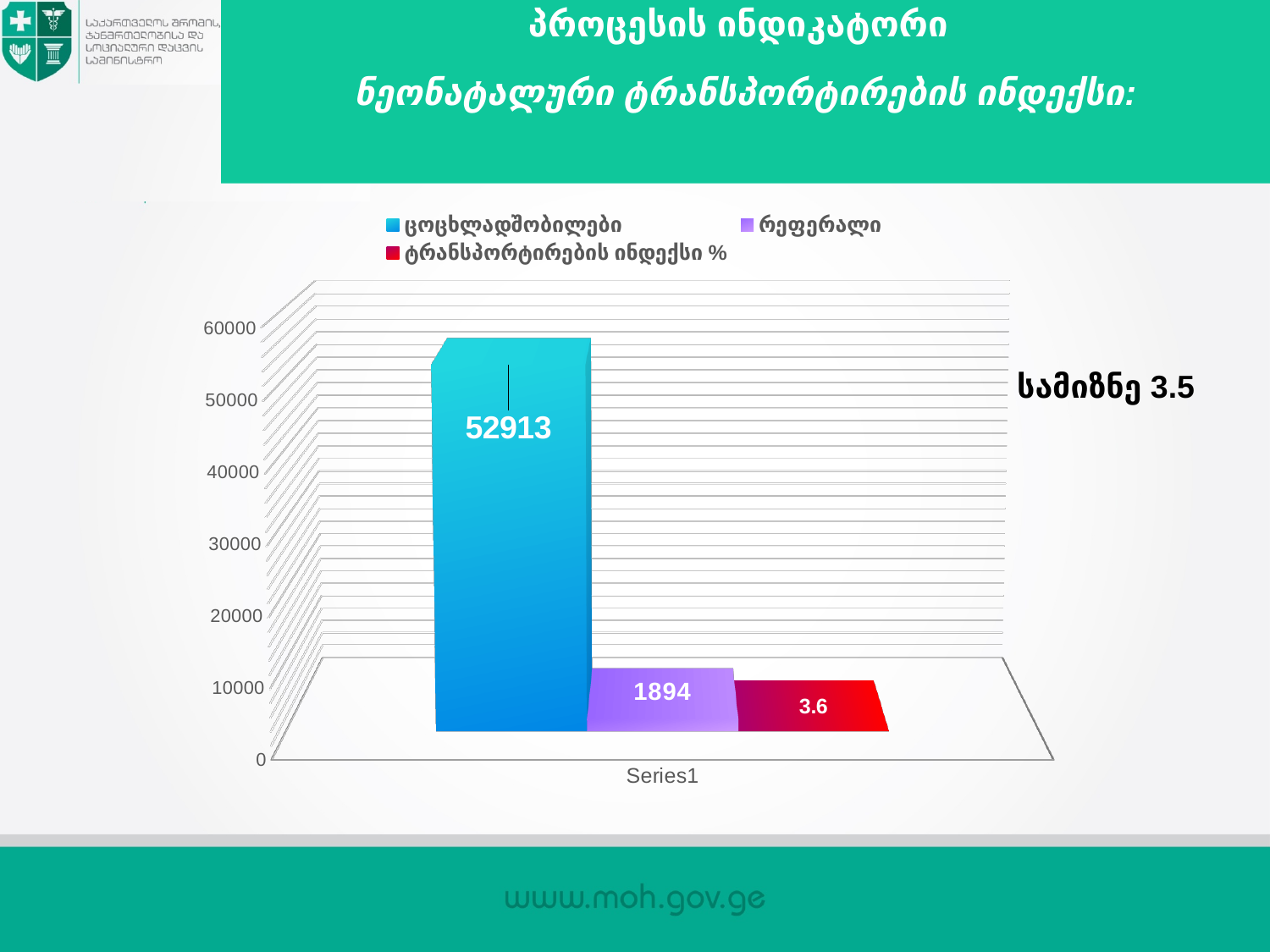
Which is larger, the რეფერალი value or the ტრანსპორტირების ინდექსი % value? რეფერალი What is the value of the ცოცხლადშობილები series? 52913 Which series has the lowest value? ტრანსპორტირების ინდექსი % How many series does the legend list? 3 Which series has the highest value? ცოცხლადშობილები What is the value of the რეფერალი series? 1894 What kind of chart is shown on the slide? bar chart What is the value of the ტრანსპორტირების ინდექსი % series? 3.6 Is the value for ცოცხლადშობილები greater or less than 50000? greater What target value (სამიზნე) is written next to the chart? 3.5 What is the category label shown on the x axis? Series1 What is the difference between the ცოცხლადშობილები value and the რეფერალი value? 51019